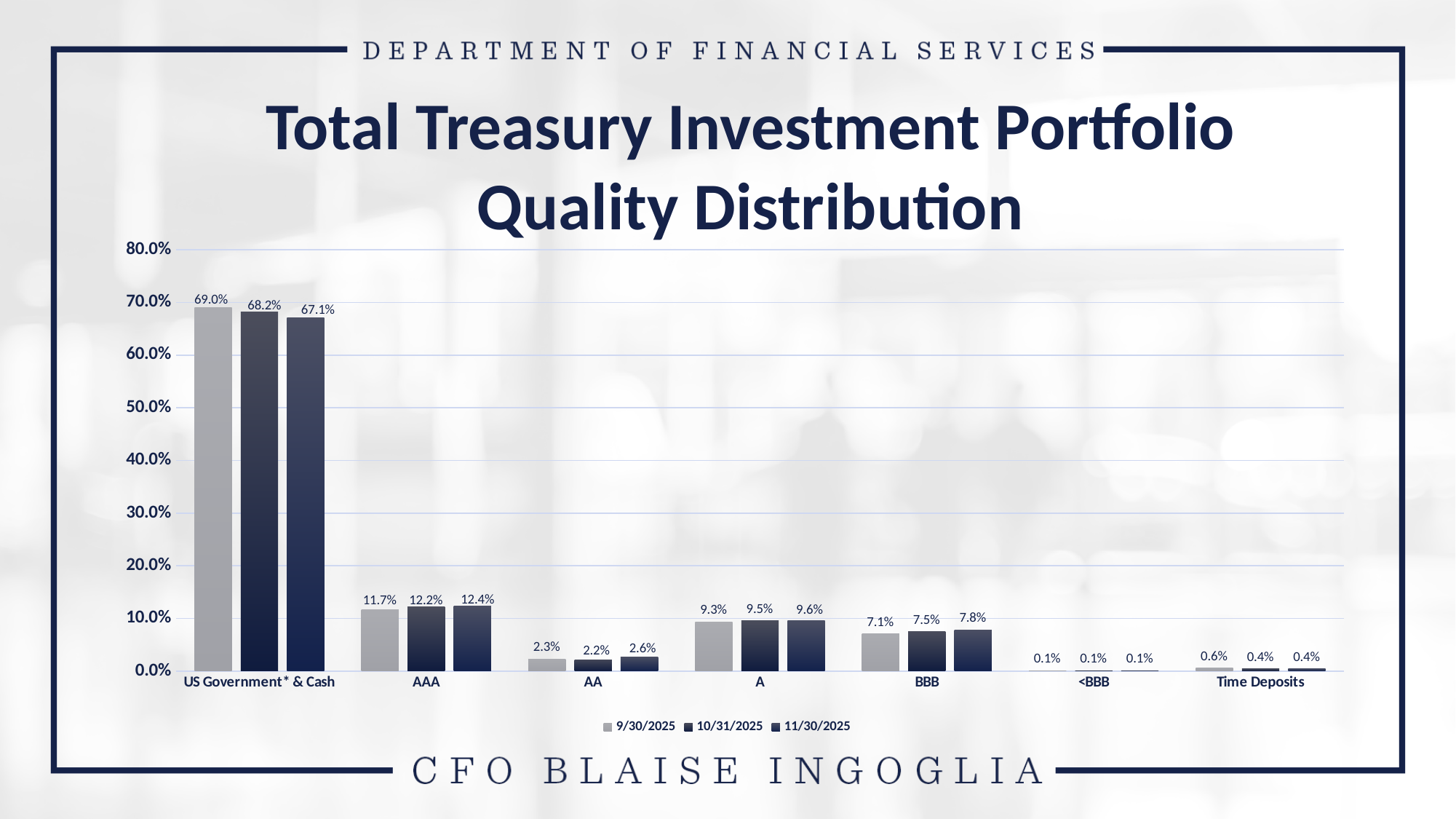
Which is larger for the A category: the 9/30/2025 value or the 11/30/2025 value? 11/30/2025 What is the value for Time Deposits for the 9/30/2025 series? 0.6% Which category has the highest value for the 11/30/2025 series? US Government* & Cash Which category has the lowest value for the 9/30/2025 series? <BBB What is the value for BBB for the 10/31/2025 series? 7.5% What kind of chart is shown on the slide? Bar chart What is the title of the chart? Total Treasury Investment Portfolio Quality Distribution What is the value for AAA for the 11/30/2025 series? 12.4% How many categories are shown on the x axis? 7 How many series does the legend list? 3 What is the value for US Government* & Cash for the 9/30/2025 series? 69.0% What is the difference between the 9/30/2025 and 11/30/2025 values for US Government* & Cash? 1.9%